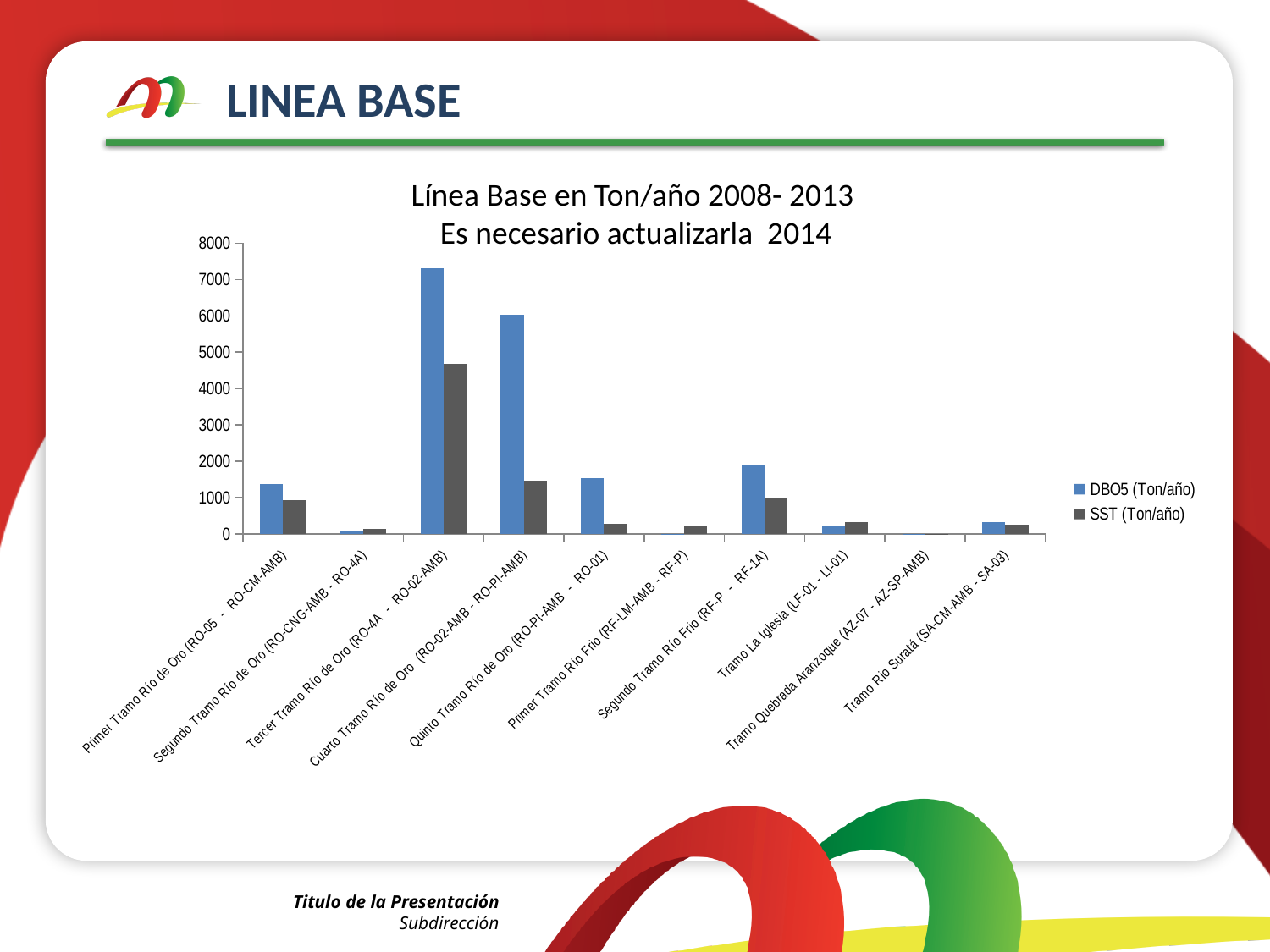
Is the SST (Ton/año) value for Quinto Tramo Río de Oro (RO-PI-AMB - RO-01) greater or less than 1000? less Which category has the highest SST (Ton/año) value? Tercer Tramo Río de Oro (RO-4A - RO-02-AMB) What kind of chart is shown on the slide? Bar chart What colour are the bars for the SST (Ton/año) series? Dark grey Is the DBO5 (Ton/año) value for Cuarto Tramo Río de Oro (RO-02-AMB - RO-PI-AMB) greater or less than 5000? greater Which is larger for Primer Tramo Río de Oro (RO-05 - RO-CM-AMB): the DBO5 (Ton/año) value or the SST (Ton/año) value? DBO5 (Ton/año) How many categories (river stretches) are shown on the x axis of the chart? 10 Is the SST (Ton/año) value for Tercer Tramo Río de Oro (RO-4A - RO-02-AMB) greater or less than 4000? greater Which has the larger DBO5 (Ton/año) value: Tercer Tramo Río de Oro (RO-4A - RO-02-AMB) or Cuarto Tramo Río de Oro (RO-02-AMB - RO-PI-AMB)? Tercer Tramo Río de Oro (RO-4A - RO-02-AMB) Which category has the highest DBO5 (Ton/año) value? Tercer Tramo Río de Oro (RO-4A - RO-02-AMB) How many series does the chart legend list? 2